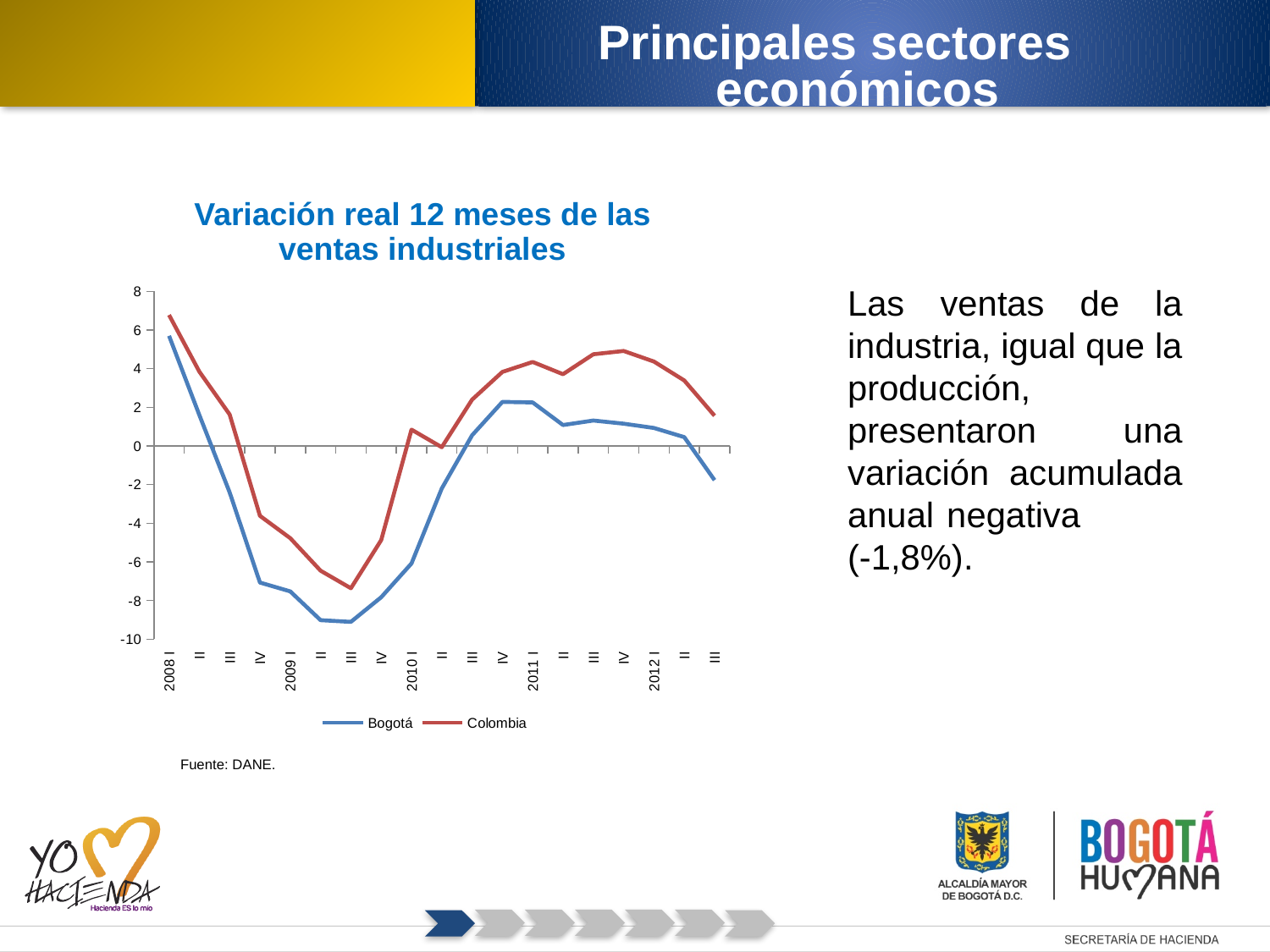
How many series does the legend of the chart list? 2 In 2009 III, which series has the higher value, Bogotá or Colombia? Colombia Is the value for Colombia in 2008 I greater or less than 6? greater How many quarterly points are plotted along the x axis, from 2008 I to 2012 III? 19 What kind of chart is shown on the slide? Line chart Is the value for Bogotá in 2009 III greater or less than -8? less Is the value for Colombia in 2011 IV greater or less than 4? greater Which two series are plotted in the chart? Bogotá and Colombia What is the title of the chart? Variación real 12 meses de las ventas industriales At which quarter does the Colombia series reach its lowest value? 2009 III At which quarter does the Colombia series reach its highest value? 2008 I